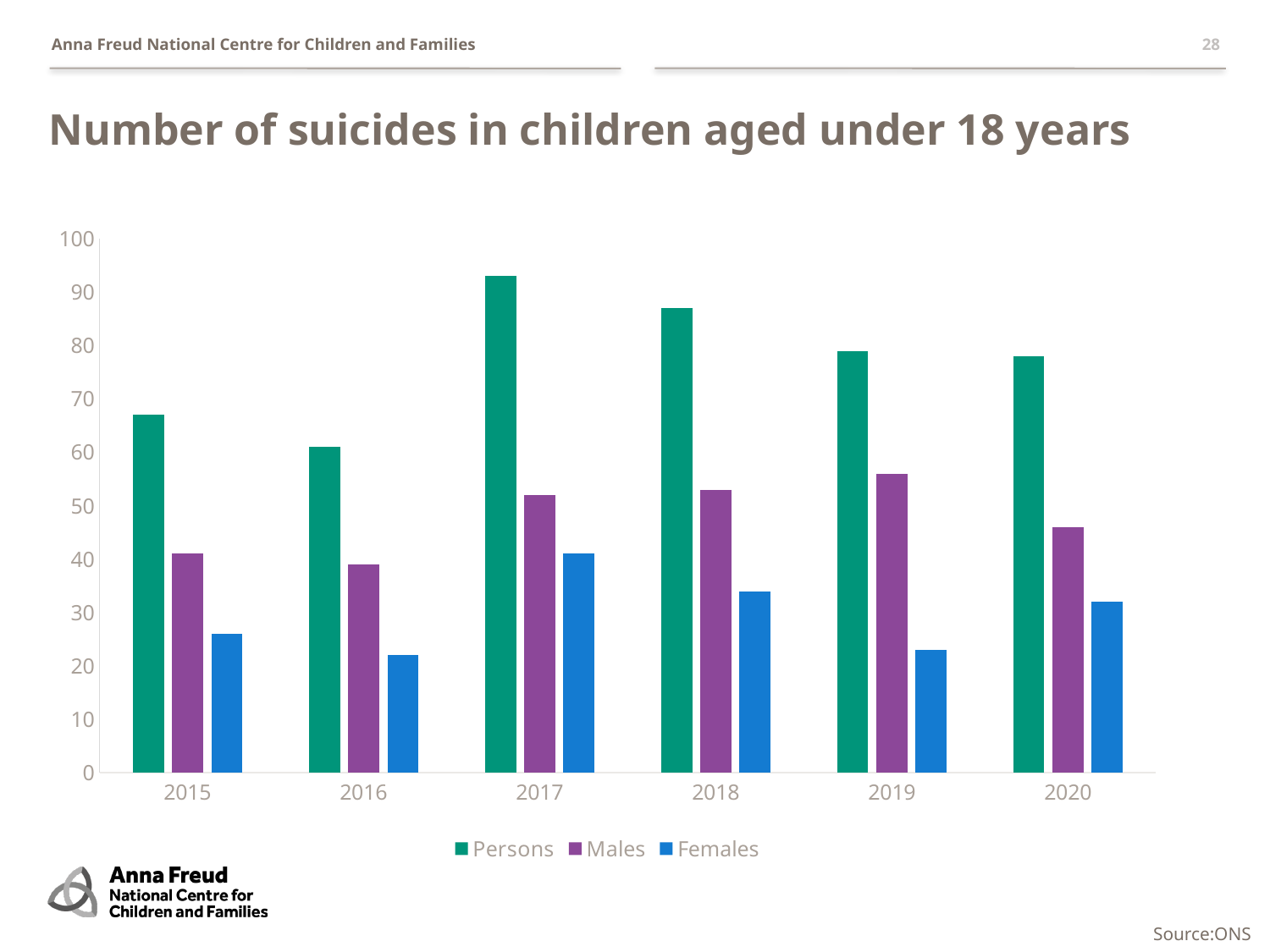
In which year is the Persons value highest? 2017 In which year is the Females value highest? 2017 What kind of chart is shown on the slide? Bar chart Is the Males value for 2020 greater or less than 50? less Is the Persons value for 2015 greater or less than 70? less How many years are shown on the x axis? 6 Which is larger, the Persons value for 2017 or for 2018? 2017 Do the Persons values rise or fall from 2017 to 2020? fall Is the Females value for 2019 greater or less than 30? less How many series does the legend list? 3 In which year is the Persons value lowest? 2016